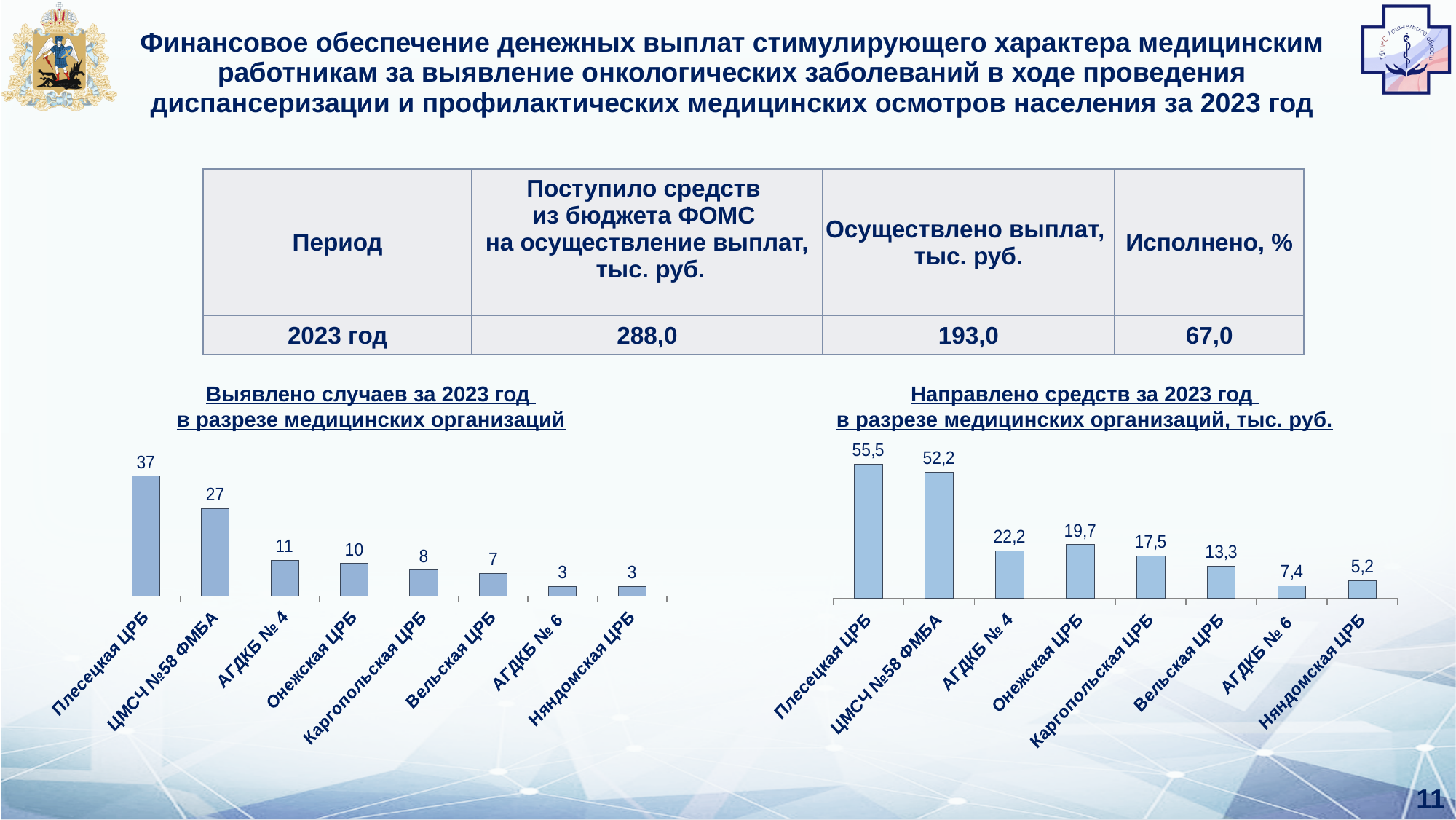
In the left chart (Выявлено случаев за 2023 год), how many organisations are shown? 8 What type of chart is the right chart (Направлено средств за 2023 год)? Bar chart In the right chart (Направлено средств за 2023 год), what is the difference between Плесецкая ЦРБ and ЦМСЧ №58 ФМБА? 3,3 In the right chart (Направлено средств за 2023 год), what is the value for Онежская ЦРБ? 19,7 In the right chart (Направлено средств за 2023 год), what is the value for Няндомская ЦРБ? 5,2 In the left chart (Выявлено случаев за 2023 год), what is the value for Каргопольская ЦРБ? 8 In the right chart (Направлено средств за 2023 год), which organisation has the lowest value? Няндомская ЦРБ In the left chart (Выявлено случаев за 2023 год), what is the difference between ЦМСЧ №58 ФМБА and АГДКБ № 4? 16 In the left chart (Выявлено случаев за 2023 год), do the values rise or fall from left to right? Fall In the left chart (Выявлено случаев за 2023 год), which organisation has the highest value? Плесецкая ЦРБ In the left chart (Выявлено случаев за 2023 год), what is the value for Плесецкая ЦРБ? 37 In the right chart (Направлено средств за 2023 год), which is larger: Каргопольская ЦРБ or Вельская ЦРБ? Каргопольская ЦРБ